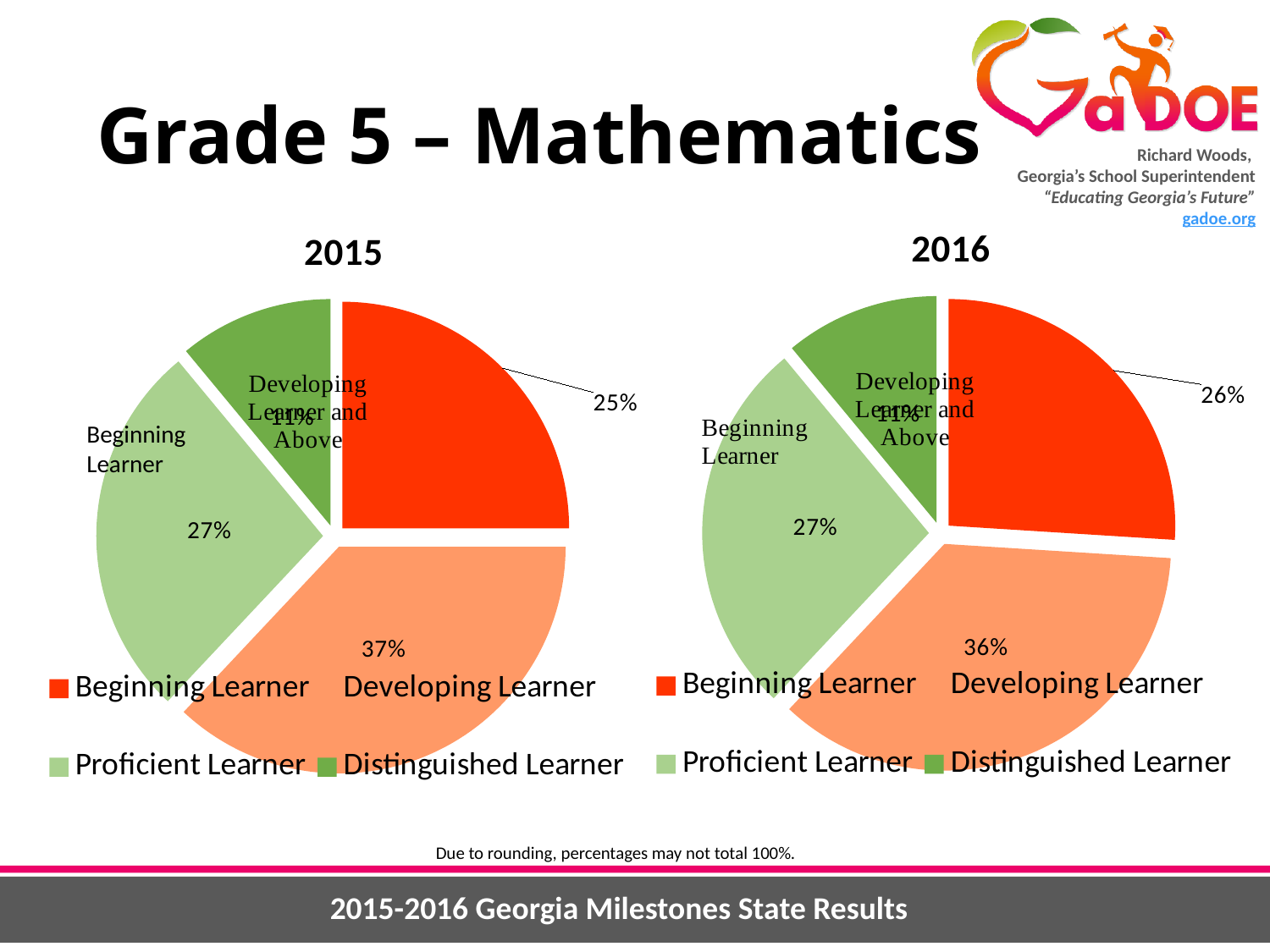
In the 2016 chart, which category has the smallest slice? Distinguished Learner In the 2015 chart, which category has the largest slice? Developing Learner In the 2015 chart, what percentage is shown for Proficient Learner? 27% In the 2016 chart, which is larger: Beginning Learner or Proficient Learner? Proficient Learner What type of chart is used for the 2016 data? Pie chart How many entries does the legend of the 2015 chart list? 4 How many slices does the 2015 pie chart have? 4 In the 2015 chart, what percentage is shown for Developing Learner? 37% In the 2015 chart, what colour represents Beginning Learner? Red What is the difference between the Developing Learner percentage in 2015 and in 2016? 1% In the 2016 chart, what percentage is shown for Distinguished Learner? 11% In the 2016 chart, what percentage is shown for Beginning Learner? 26%